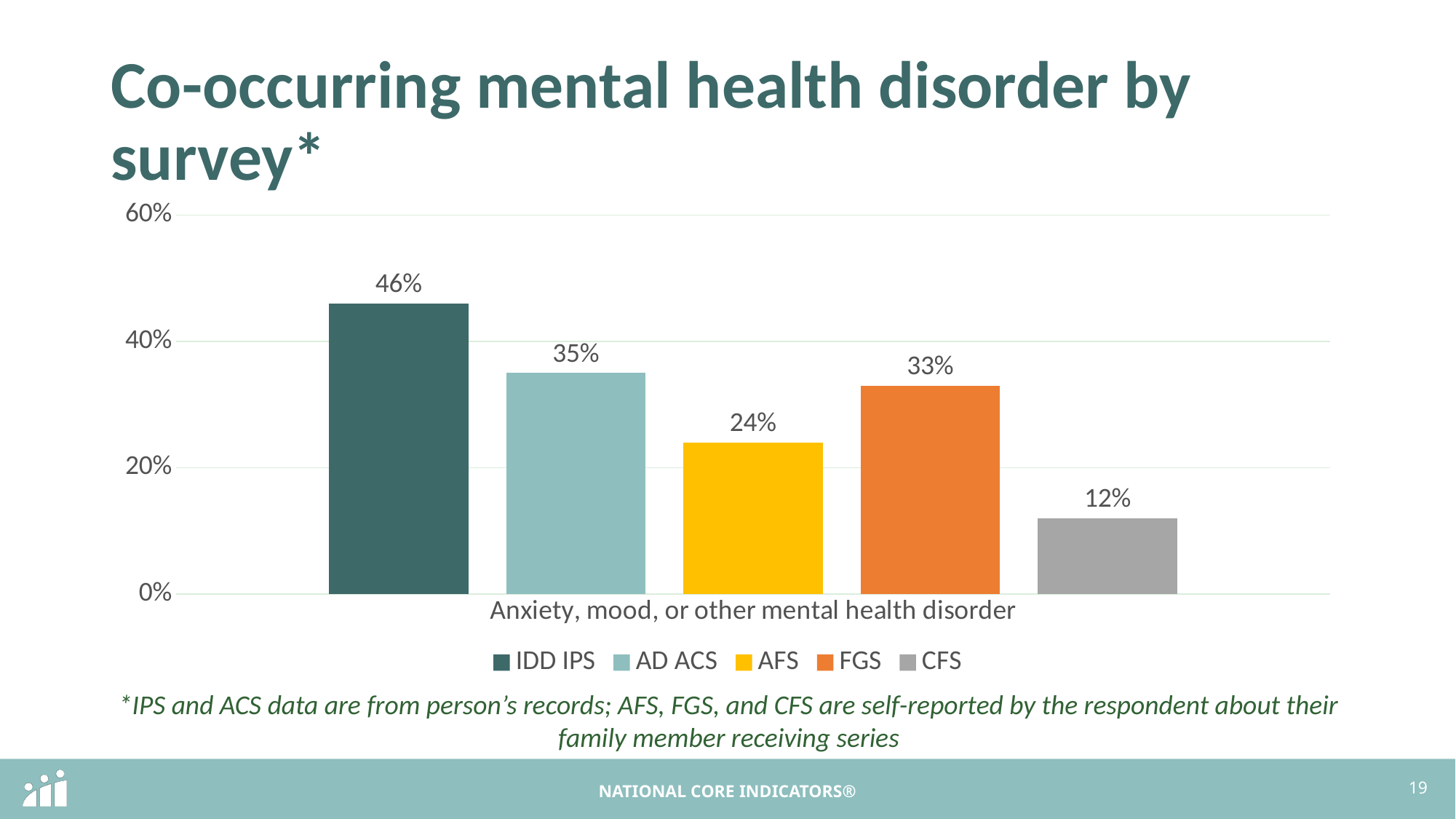
What is the value for CFS? 12% What is the value for AFS? 24% What is the category label shown on the x axis? Anxiety, mood, or other mental health disorder Which is larger, the value for AD ACS or the value for FGS? AD ACS What is the value for AD ACS? 35% Which survey has the highest value? IDD IPS What is the value for FGS? 33% How many series does the legend list? 5 What is the value for IDD IPS? 46% What kind of chart is shown on the slide? Bar chart Which survey has the lowest value? CFS What is the difference between the IDD IPS value and the CFS value? 34%